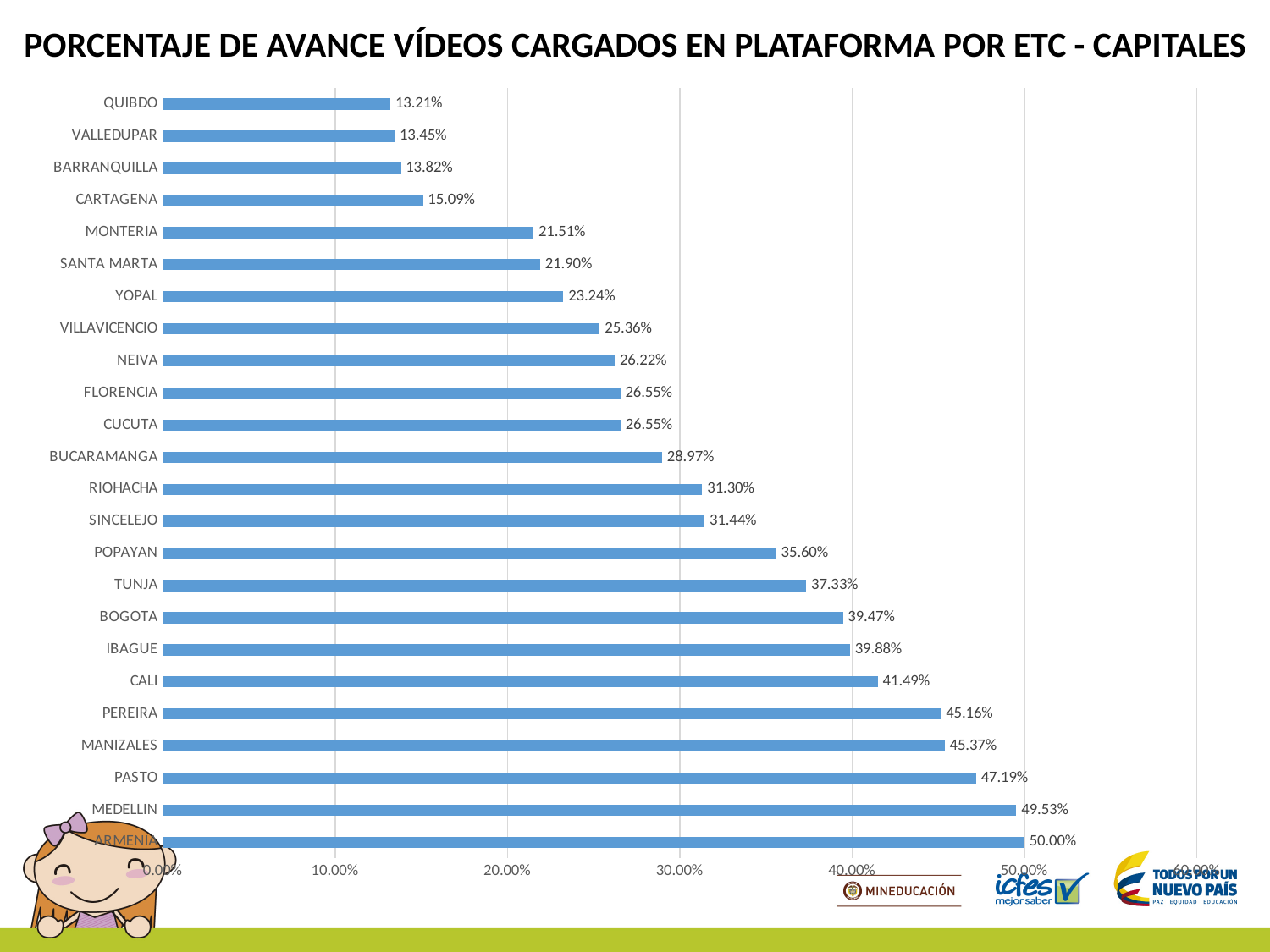
How many cities are shown in the chart? 24 What is the title of the chart? PORCENTAJE DE AVANCE VÍDEOS CARGADOS EN PLATAFORMA POR ETC - CAPITALES What kind of chart is shown on the slide? bar chart What is the value for BOGOTA? 39.47% Which is larger, the value for RIOHACHA or the value for POPAYAN? POPAYAN What is the difference between the values for CALI and TUNJA? 4.16% Which city has the lowest percentage? QUIBDO What is the value for SANTA MARTA? 21.90% Which city has the highest percentage? ARMENIA What is the value for PEREIRA? 45.16% What is the difference between the values for MEDELLIN and PASTO? 2.34% Is the value for IBAGUE greater or less than 30.00%? greater